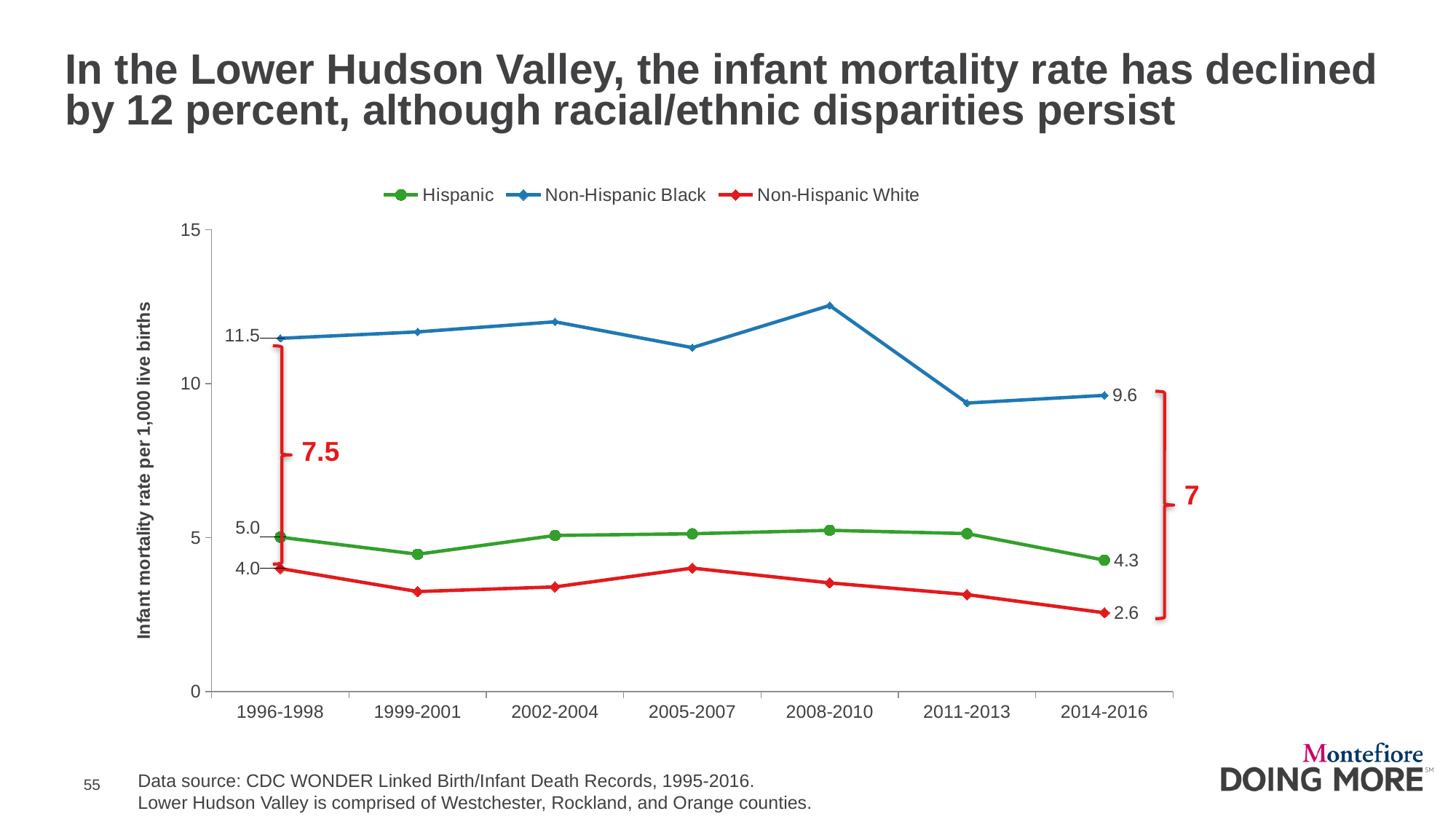
What was the infant mortality rate for Non-Hispanic Black in 1996-1998? 11.5 What type of chart is shown on the slide? line chart Which group had the lowest infant mortality rate in 1996-1998? Non-Hispanic White What was the infant mortality rate for Non-Hispanic White in 2014-2016? 2.6 What was the infant mortality rate for Hispanic in 1996-1998? 5.0 Does the Non-Hispanic White rate rise or fall from 1996-1998 to 2014-2016? fall Is the Non-Hispanic Black rate in 2008-2010 greater or less than 10? greater What is the difference between the Non-Hispanic Black and Non-Hispanic White rates in 1996-1998? 7.5 How many time periods are shown on the x axis? 7 How many series does the legend list? 3 What was the infant mortality rate for Hispanic in 2014-2016? 4.3 Which group had the highest infant mortality rate in 2014-2016? Non-Hispanic Black